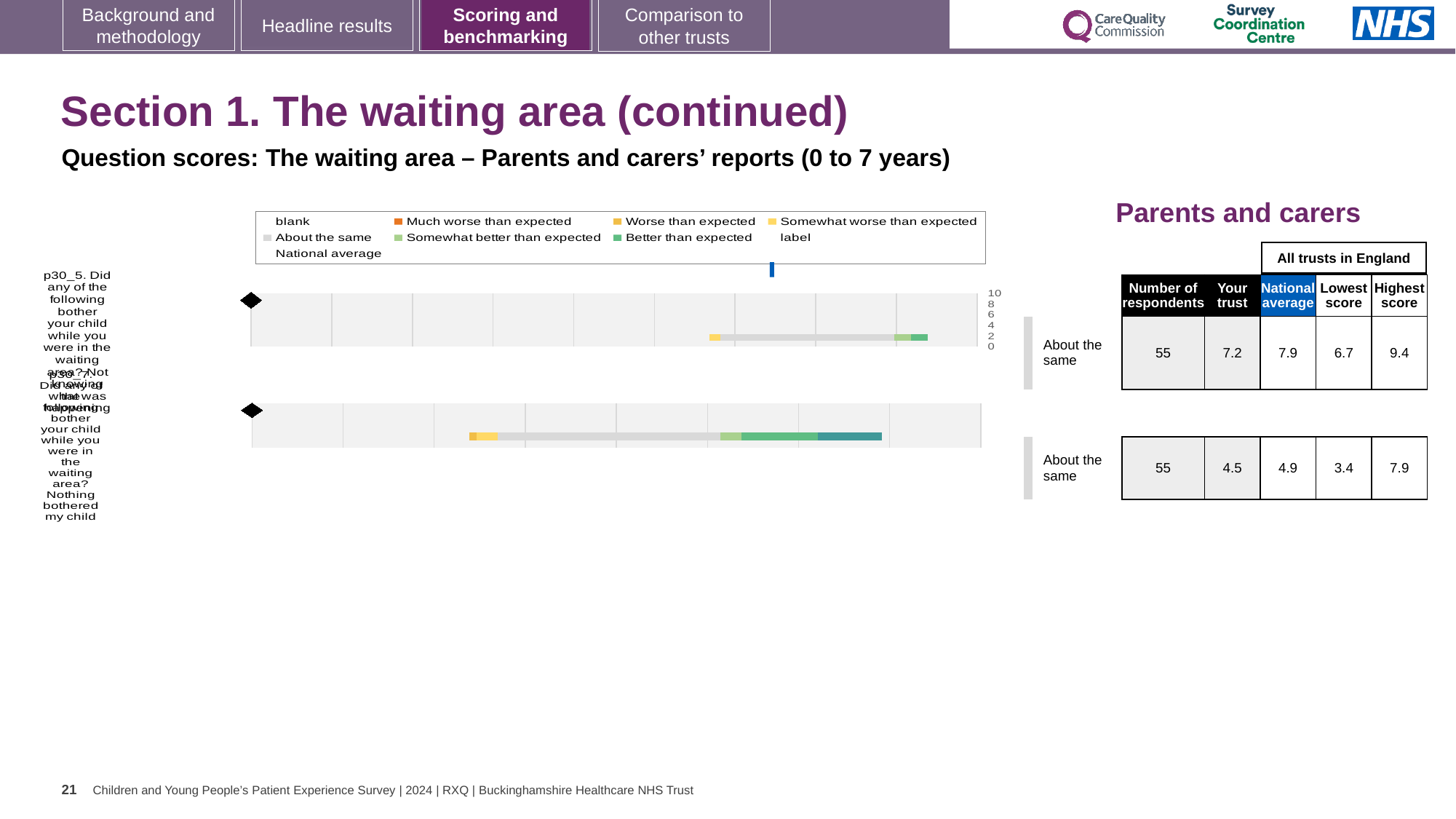
In the table beside the chart, what is the 'Your trust' score for the first question (p30_5)? 7.2 In the table beside the chart, for the first question (p30_5), which is larger: the 'Your trust' score or the national average? National average How many entries does the chart legend list? 9 What kind of chart is shown on the slide? bar chart Which legend entry is shown in dark green? Better than expected In the table beside the chart, what is the lowest score for the second question (p30_7)? 3.4 In the table beside the chart, what is the difference between the highest score and the lowest score for the first question (p30_5)? 2.7 In the table beside the chart, what is the national average for the second question (p30_7)? 4.9 What colour does the legend use for 'Much worse than expected'? orange In the table beside the chart, how many respondents answered the first question (p30_5)? 55 In the table beside the chart, what is the difference between the highest score and the lowest score for the second question (p30_7)? 4.5 How many question bars are plotted in the chart? 2